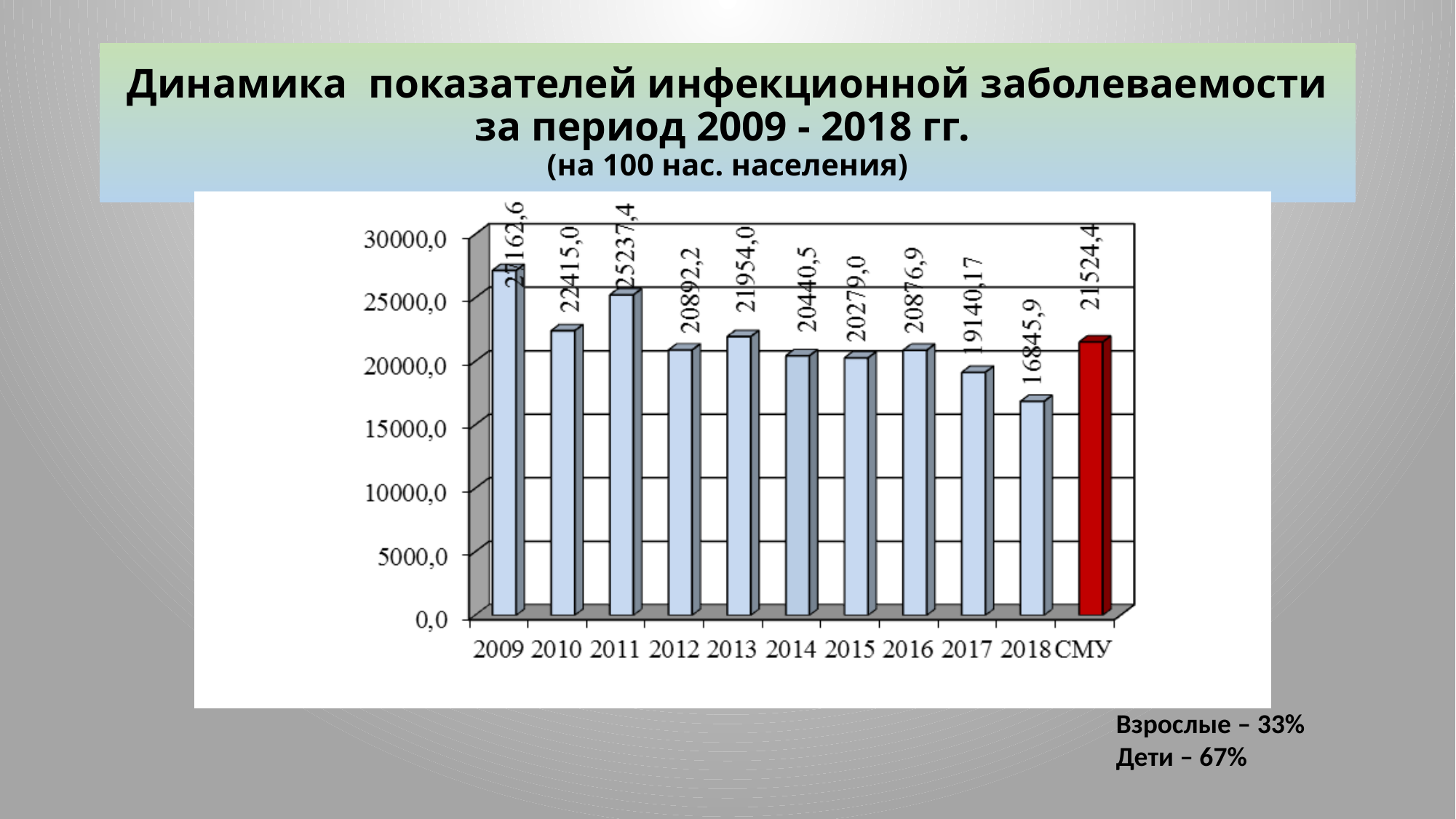
How many bars are shown in the chart? 11 Is the value for 2017 greater or less than 20000,0? less What kind of chart is shown on the slide? bar chart What colour is the bar for СМУ? red What is the difference between the values for 2010 and 2018? 5569,1 Which is larger, the value for 2013 or the value for 2014? 2013 What is the value for 2018? 16845,9 What is the value for 2015? 20279,0 What is the value for СМУ? 21524,4 Which category has the highest value? 2009 Which year has the lowest value? 2018 What is the value for 2011? 25237,4